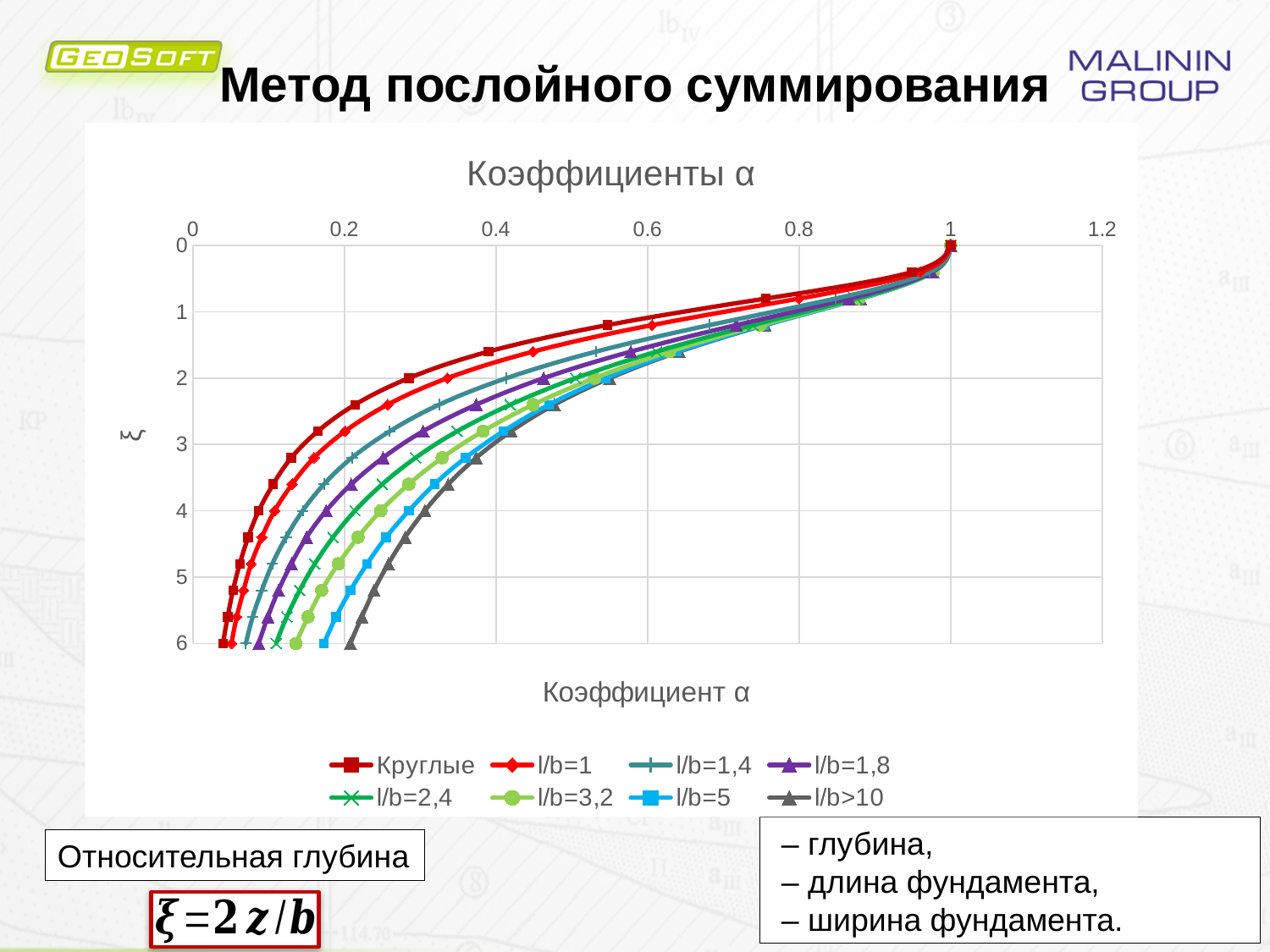
Is the value of α for l/b>10 at ξ = 2 greater or less than 0.4? greater How many series does the legend of the chart list? 8 Which series has the highest value of α at ξ = 6? l/b>10 Which series has the lowest value of α at ξ = 6? Круглые Is the value of α for l/b>10 at ξ = 4 greater or less than 0.2? greater At ξ = 4, which series has the larger value of α, Круглые or l/b>10? l/b>10 Is the value of α for Круглые at ξ = 6 greater or less than 0.2? less Which legend entry is drawn with green circle markers? l/b=3,2 What value of α do all the curves reach at ξ = 0? 1 What is the title of the chart? Коэффициенты α As ξ increases from 0 to 6, does the value of α for each series rise or fall? fall What kind of chart is shown on the slide? line chart